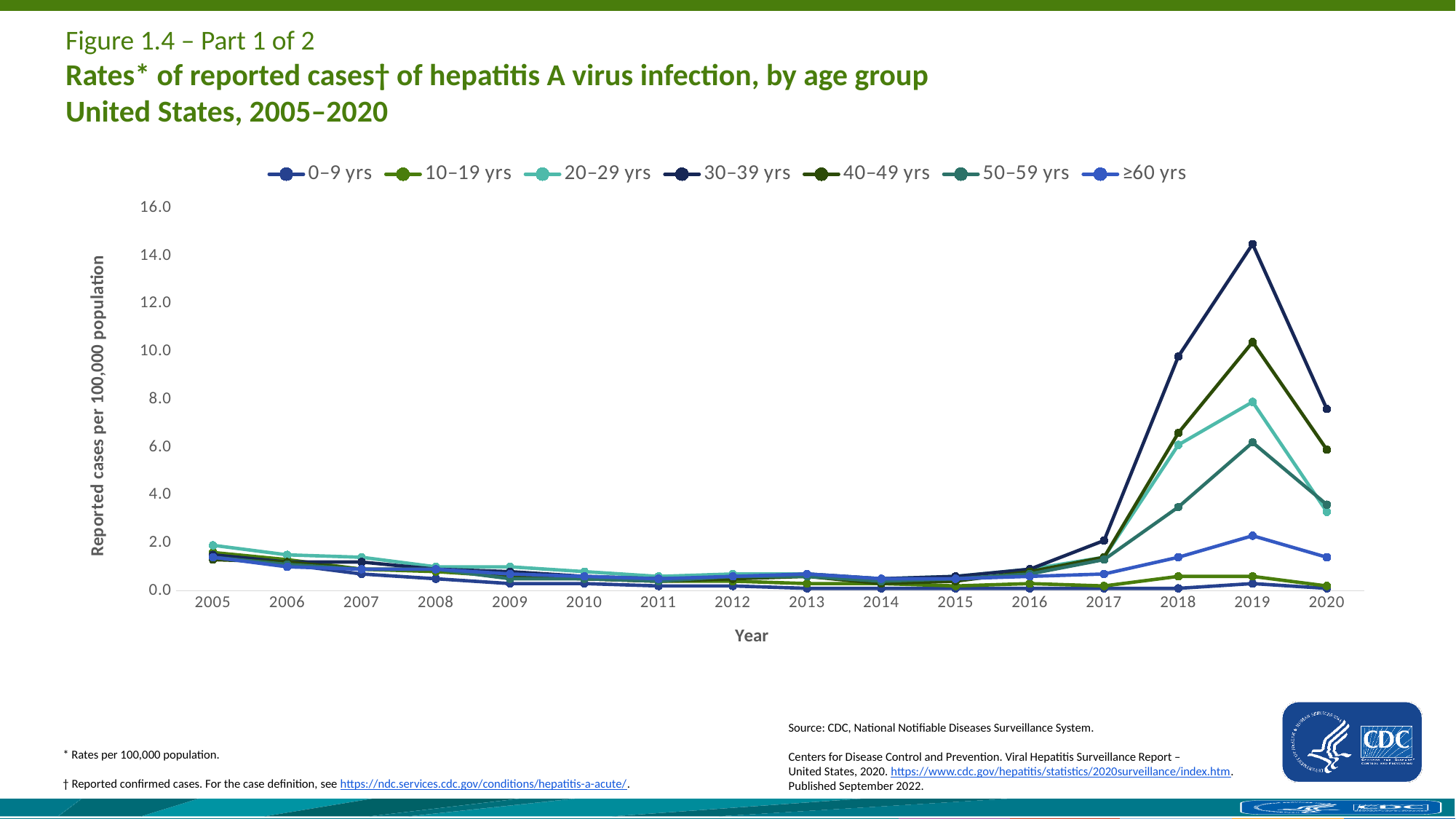
Which age group has the highest rate in 2019? 30–39 yrs In which year does the 30–39 yrs series reach its peak? 2019 Is the value for 50–59 yrs in 2018 greater or less than 4.0? less How many years are plotted along the x axis? 16 What is the label of the y axis? Reported cases per 100,000 population Is the value for 30–39 yrs in 2020 greater or less than 6.0? greater What kind of chart is shown on the slide? line chart Does the 30–39 yrs series rise or fall from 2017 to 2019? rise How many age-group series does the legend list? 7 Is the value for 30–39 yrs in 2019 greater or less than 12.0? greater In 2019, which is larger: the rate for 40–49 yrs or for 20–29 yrs? 40–49 yrs